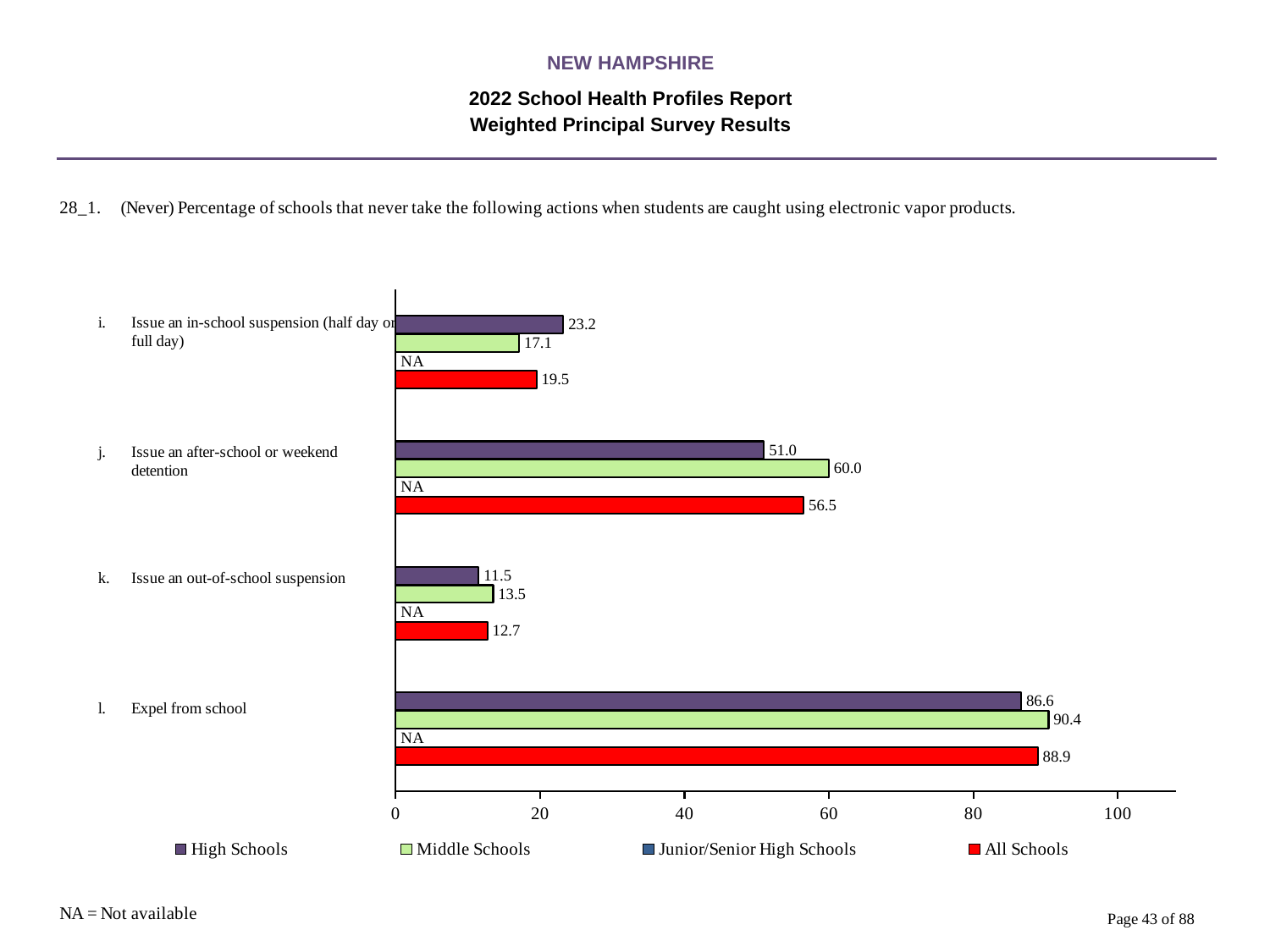
Which action has the lowest value for High Schools? Issue an out-of-school suspension What is the value for All Schools for 'Expel from school'? 88.9 How many actions (categories) are shown in the chart? 4 What is the difference between the Middle Schools and High Schools values for 'Issue an after-school or weekend detention'? 9.0 What is the value for High Schools for 'Issue an in-school suspension (half day or full day)'? 23.2 Is the All Schools value for 'Issue an after-school or weekend detention' greater or less than 40? greater For 'Issue an out-of-school suspension', which is larger: the High Schools value or the Middle Schools value? Middle Schools What kind of chart is shown on the slide? bar chart Which action has the highest value for All Schools? Expel from school What is the value for Middle Schools for 'Issue an after-school or weekend detention'? 60.0 How many series does the legend list? 4 What is the value for Junior/Senior High Schools for 'Issue an out-of-school suspension'? NA